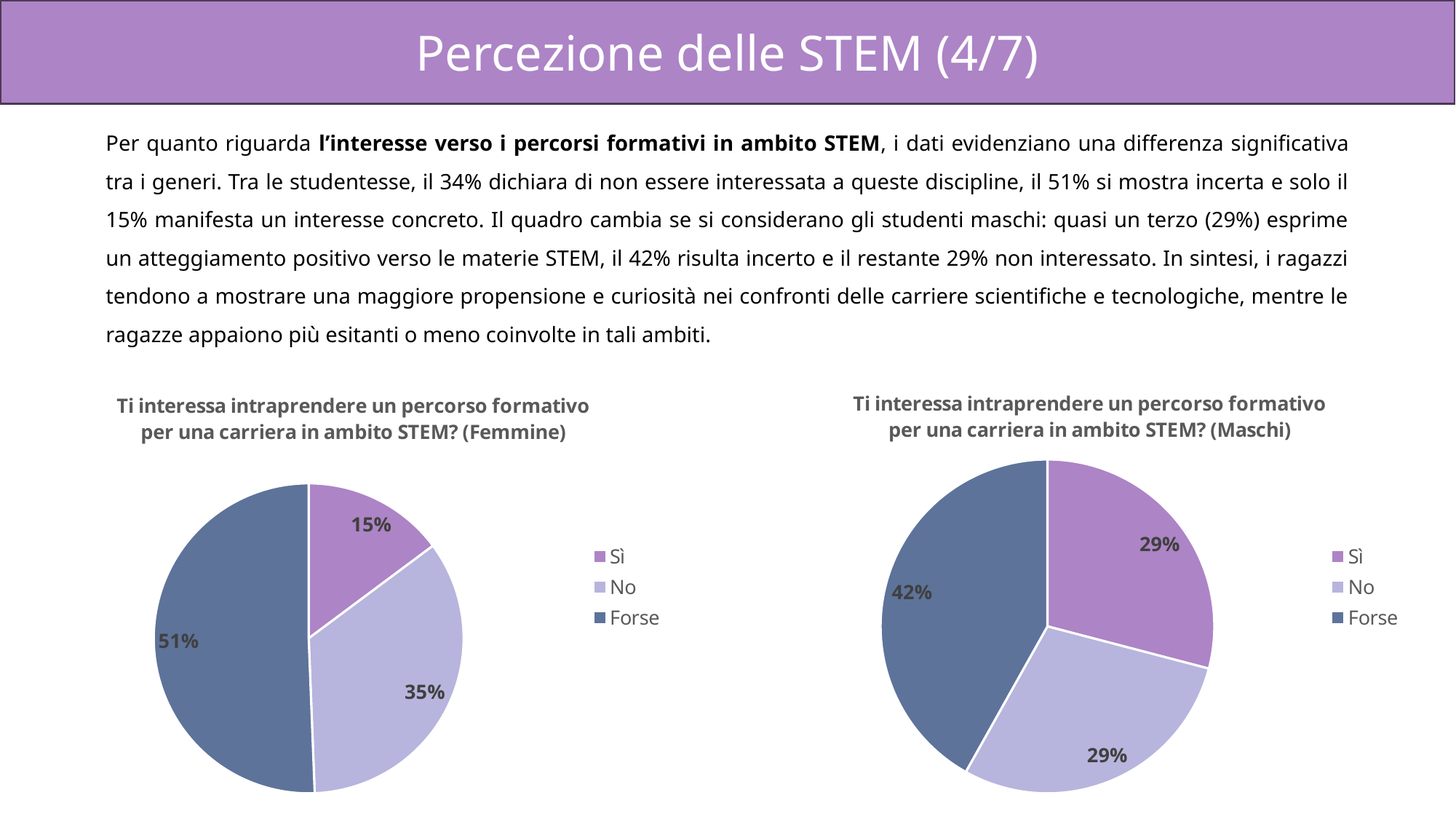
In the Maschi chart on the right, what percentage answered "Sì"? 29% In the Femmine chart on the left, what share of respondents answered "Sì"? 15% Comparing the two charts, is the "Sì" share larger for Femmine or for Maschi? Maschi In the Femmine chart on the left, which answer has the smallest slice? Sì What type of chart is used on this slide? Pie chart In the Maschi chart on the right, what percentage answered "Forse"? 42% In the Maschi chart on the right, what is the difference between the "Forse" and "No" percentages? 13% In the Femmine chart on the left, which answer has the largest slice? Forse In the Femmine chart on the left, what is the difference between the "Forse" and "Sì" percentages? 36% In the Maschi chart on the right, which answer has the largest slice? Forse In the Femmine chart on the left, what percentage answered "No"? 35% In the chart titled "Ti interessa intraprendere un percorso formativo per una carriera in ambito STEM? (Femmine)", what percentage answered "Forse"? 51%